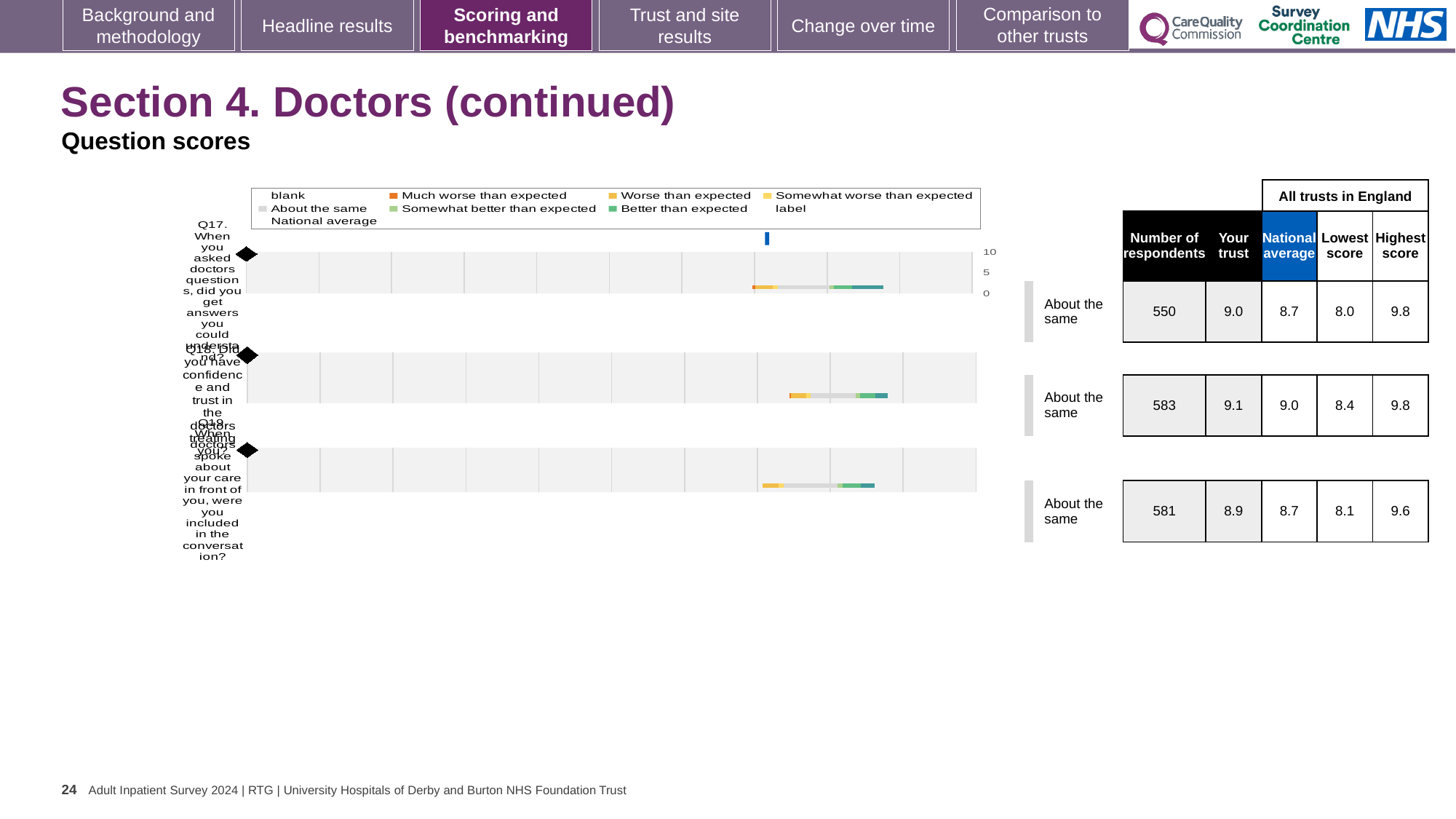
Which question has the lowest 'Your trust' score? Q19 What benchmark category is shown for all three questions on the slide? About the same For Q19, which is larger: the 'Your trust' score or the national average? Your trust What is the national average score for Q17 (answers you could understand)? 8.7 What is the highest score across all trusts in England for Q19? 9.6 How many questions (Q17, Q18, Q19) are plotted on the slide? 3 What kind of chart is used to show the question scores on this slide? bar chart What is the 'Your trust' score for Q18 (confidence and trust in the doctors)? 9.1 What is the lowest score across all trusts in England for Q17? 8.0 What is the difference between the 'Your trust' score and the national average for Q17? 0.3 How many respondents answered Q19 (included in the conversation)? 581 Which question has the highest 'Your trust' score? Q18